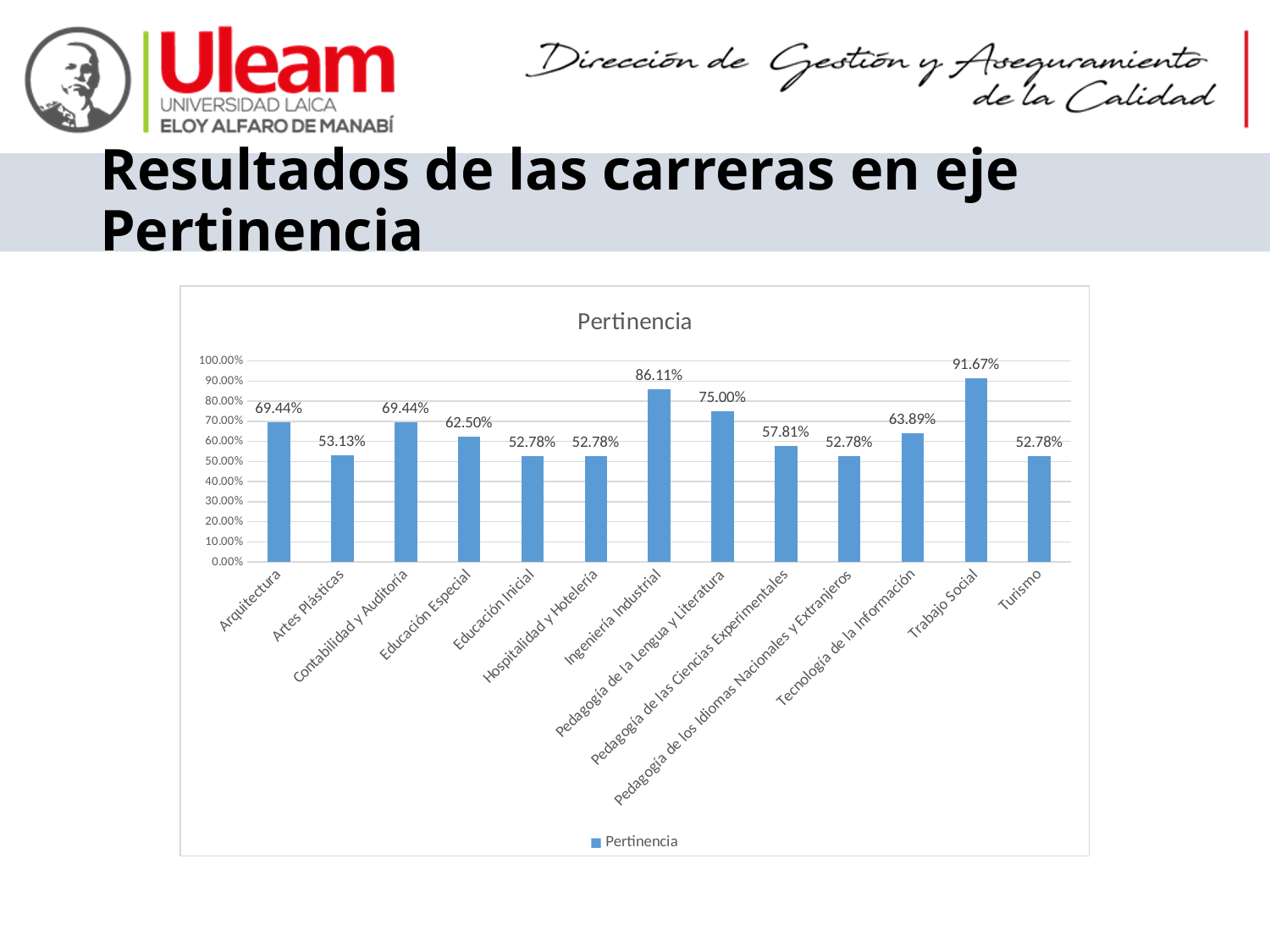
What is the value for Artes Plásticas in the Pertinencia chart? 53.13% What is the lowest value shown in the Pertinencia chart? 52.78% What kind of chart is shown on the slide? Bar chart Which is larger, the value for Tecnología de la Información or the value for Arquitectura? Arquitectura Which career has the highest Pertinencia value? Trabajo Social How many series does the legend of the chart list? 1 What is the difference between the values for Trabajo Social and Ingeniería Industrial? 5.56% What is the value for Pedagogía de las Ciencias Experimentales? 57.81% What is the value for Trabajo Social in the Pertinencia chart? 91.67% How many careers are shown in the Pertinencia chart? 13 What is the value for Ingeniería Industrial in the Pertinencia chart? 86.11% What is the difference between the values for Pedagogía de la Lengua y Literatura and Educación Especial? 12.50%